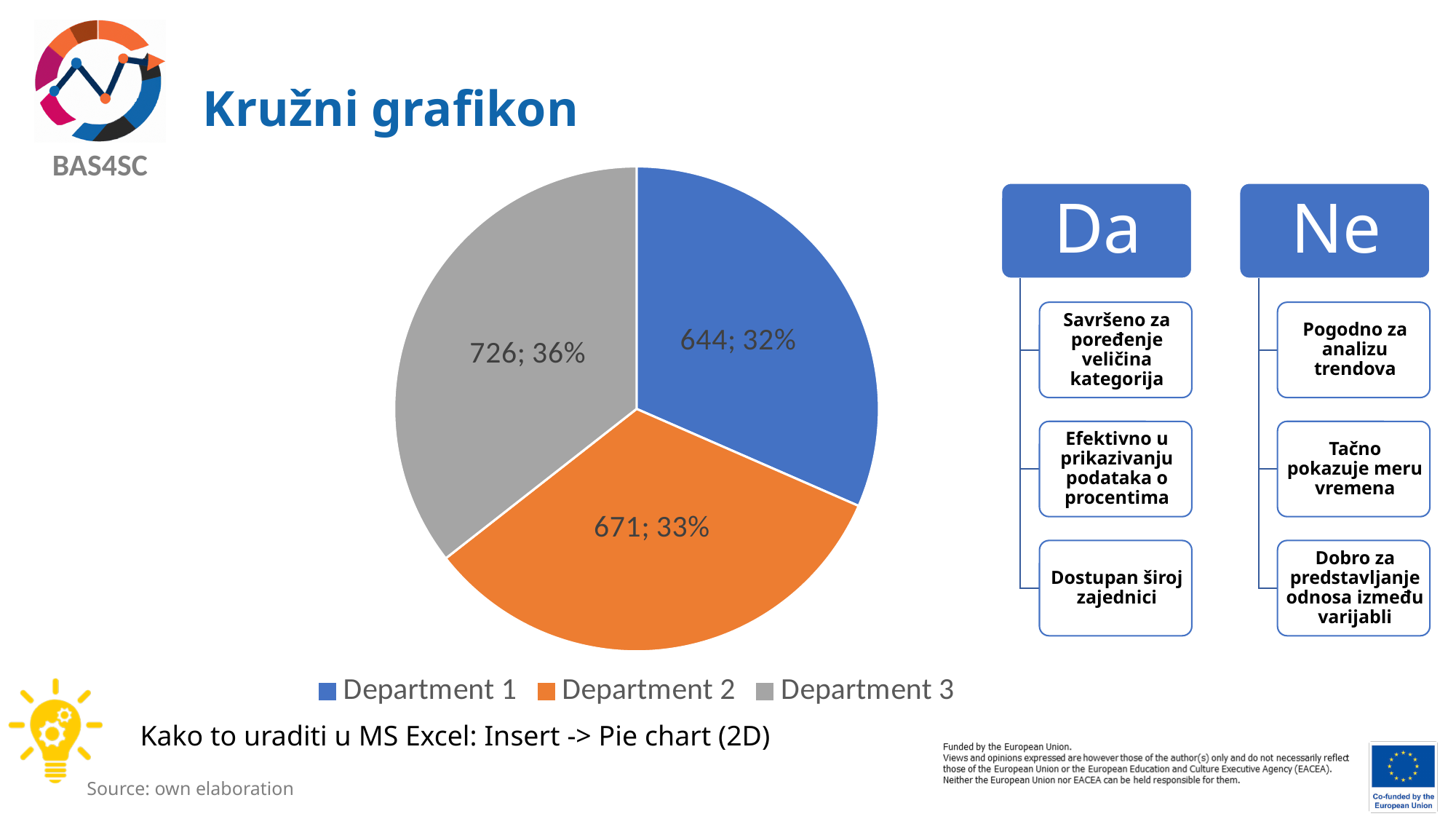
How many entries does the legend list? 3 What is the difference between the values for Department 3 and Department 1? 82 What is the value for Department 1? 644 What colour is the slice for Department 2? orange What kind of chart is shown on the slide? pie chart How many slices does the pie chart have? 3 What is the value for Department 2? 671 What share of the pie does Department 1 represent? 32% Which department has the largest slice? Department 3 What share of the pie does Department 3 represent? 36% What is the value for Department 3? 726 Which department has the smallest slice? Department 1